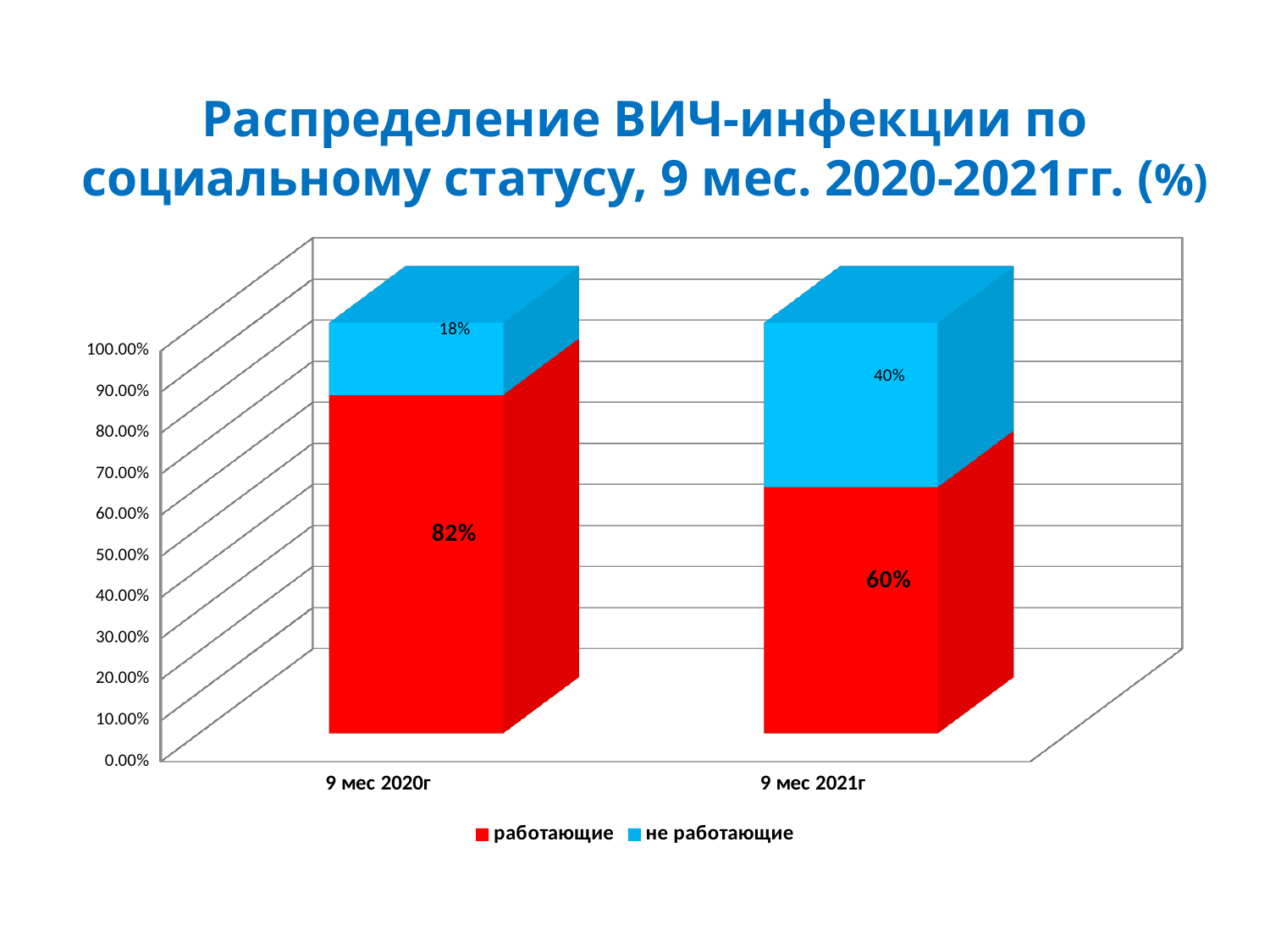
What is the value for не работающие in 9 мес 2020г? 18% Which is larger in 9 мес 2021г: работающие or не работающие? работающие How many categories are shown on the x axis? 2 How many series does the legend list? 2 What is the difference between the работающие values for 9 мес 2020г and 9 мес 2021г? 22% In which category is the value for работающие highest? 9 мес 2020г What is the value for работающие in 9 мес 2020г? 82% What is the value for работающие in 9 мес 2021г? 60% What is the value for не работающие in 9 мес 2021г? 40% In which category is the value for не работающие lowest? 9 мес 2020г Does the value for работающие rise or fall from 9 мес 2020г to 9 мес 2021г? fall What kind of chart is shown on the slide? stacked bar chart